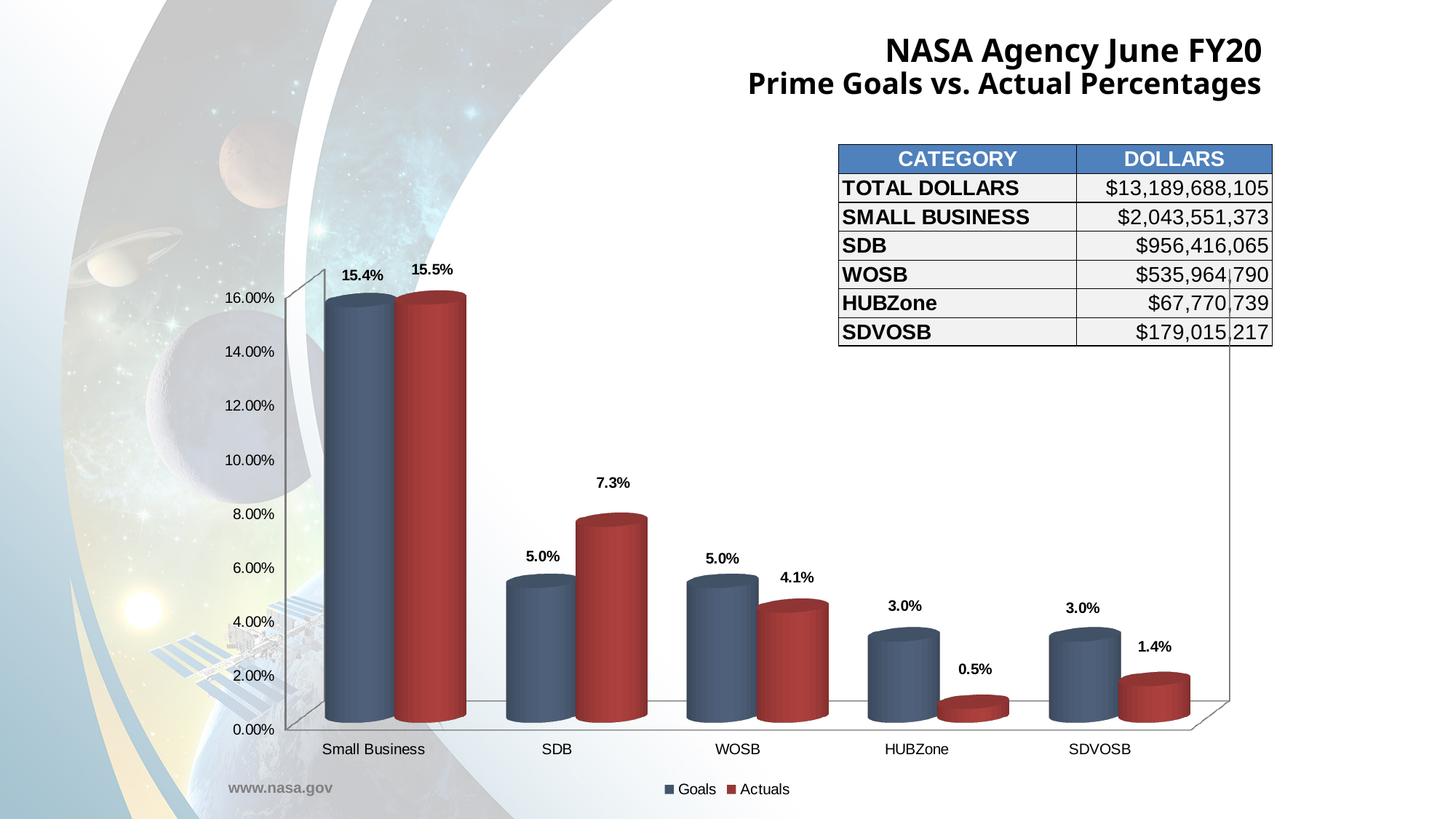
What is the difference between the Goals and Actuals values for WOSB? 0.9% Is the Actuals value for SDVOSB greater or less than 2.00%? less What is the Actuals value for HUBZone? 0.5% What is the Actuals value for SDB? 7.3% What is the Goals value for SDVOSB? 3.0% Which category has the lowest Actuals value? HUBZone What is the Goals value for Small Business? 15.4% What kind of chart is shown on the slide? Bar chart Which category has the highest Actuals value? Small Business How many series does the chart legend list? 2 Which is larger for SDB, the Goals value or the Actuals value? Actuals How many categories are shown on the x axis of the chart? 5